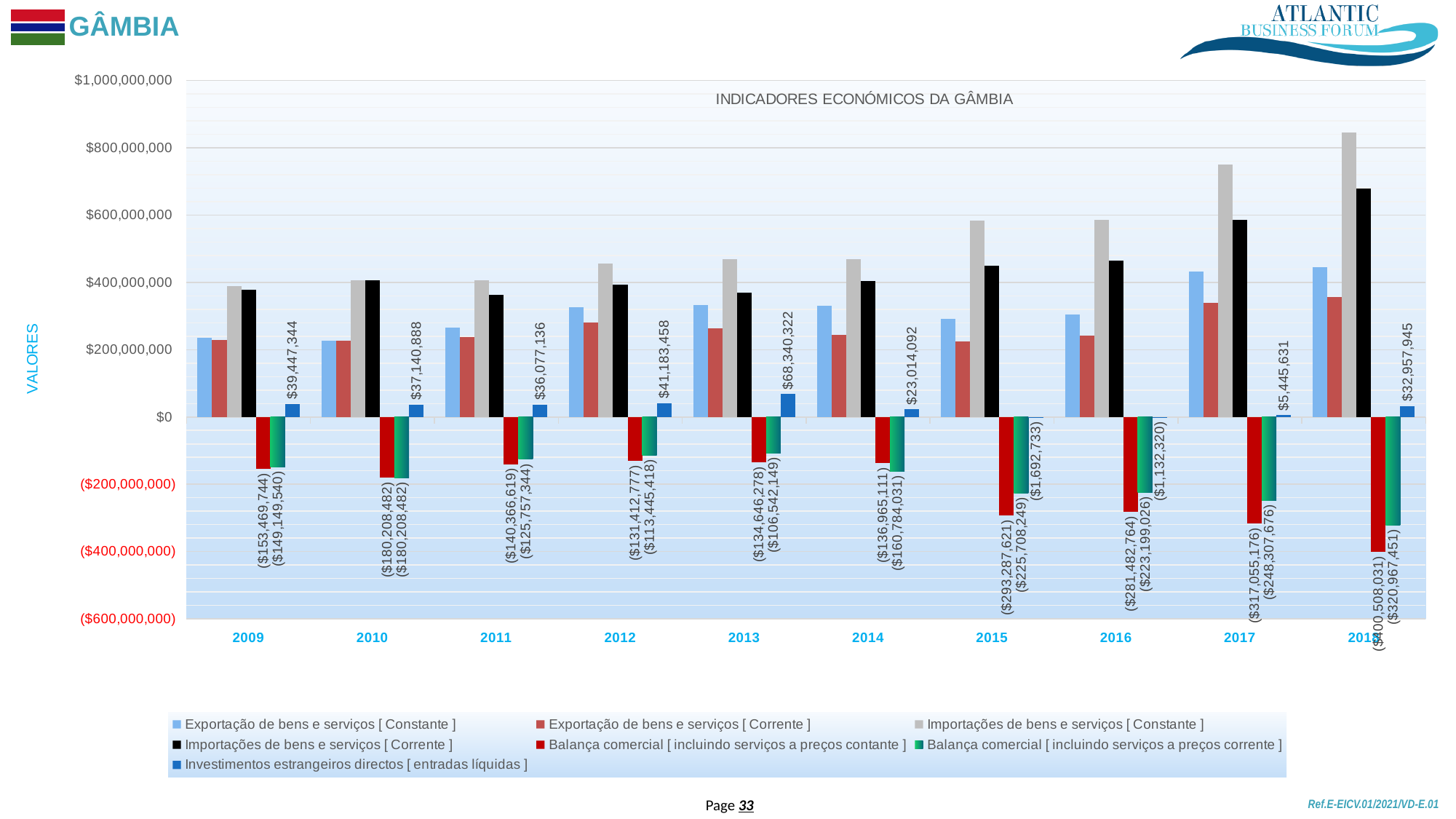
What kind of chart is shown on the slide? Bar chart How many series does the chart's legend list? 7 What is the value of Balança comercial [ incluindo serviços a preços contante ] in 2018? ($400,508,031) What is the difference between Investimentos estrangeiros directos [ entradas líquidas ] in 2012 and in 2011? $5,106,322 Which is larger in 2014: Balança comercial [ incluindo serviços a preços contante ] or Balança comercial [ incluindo serviços a preços corrente ]? Balança comercial [ incluindo serviços a preços contante ] What is the title of the chart? INDICADORES ECONÓMICOS DA GÂMBIA Does Importações de bens e serviços [ Constante ] generally rise or fall from 2009 to 2018? Rise In which year is Investimentos estrangeiros directos [ entradas líquidas ] highest? 2013 Is the value for Importações de bens e serviços [ Constante ] in 2018 greater or less than $800,000,000? greater What is the value of Investimentos estrangeiros directos [ entradas líquidas ] in 2013? $68,340,322 In which year is Investimentos estrangeiros directos [ entradas líquidas ] lowest? 2015 How many years are shown on the x axis of the chart? 10